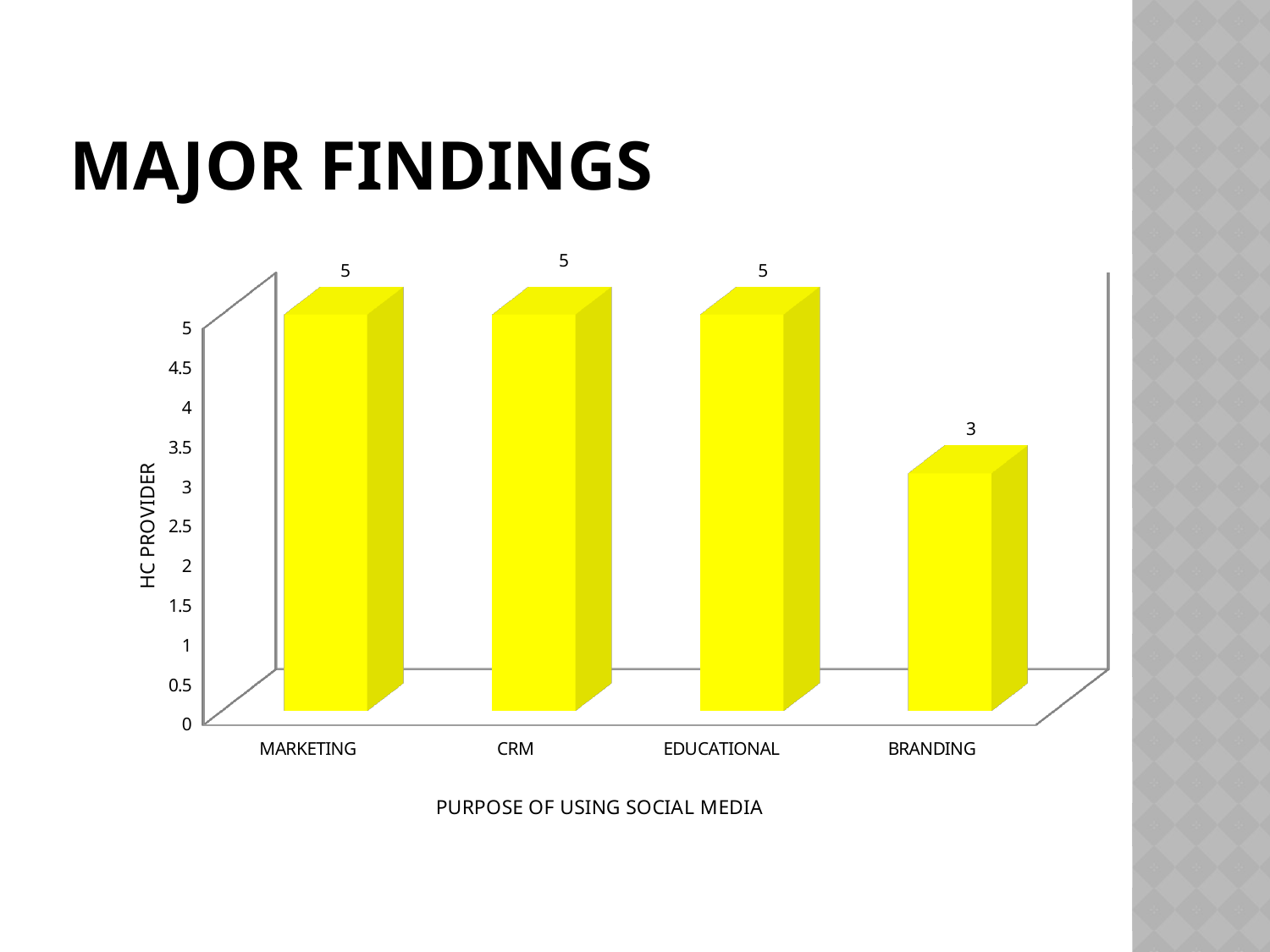
What is the label of the y axis? HC PROVIDER How many categories have a value of 5? 3 What is the difference between the values for EDUCATIONAL and BRANDING? 2 What is the value for BRANDING? 3 What is the value for CRM? 5 What is the value for MARKETING? 5 Is the value for BRANDING greater or less than 4? less How many categories are shown on the x axis? 4 Which category has the lowest value? BRANDING Which is larger, the value for CRM or the value for BRANDING? CRM What kind of chart is shown on the slide? bar chart What is the label of the x axis? PURPOSE OF USING SOCIAL MEDIA